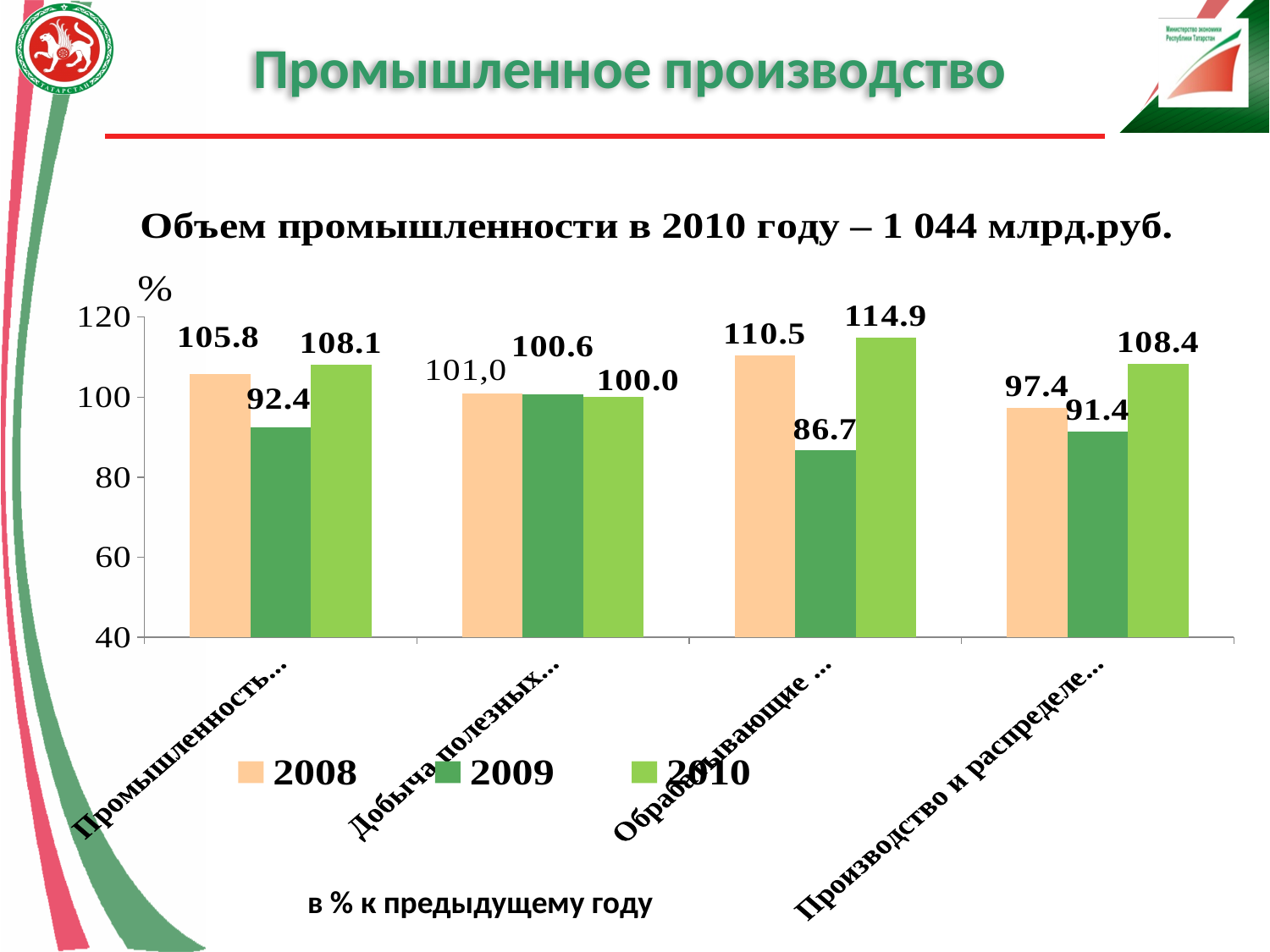
What is the difference between the 2010 and 2009 values for the category labelled "Обрабатывающие ..."? 28.2 What kind of chart is shown on the slide? bar chart Which category has the highest 2010 value? Обрабатывающие ... How many series does the legend list? 3 What is the 2010 value for the category labelled "Обрабатывающие ..."? 114.9 What is the 2008 value for the category labelled "Производство и распределе..."? 97.4 What is the 2009 value for the category labelled "Промышленность..."? 92.4 How many categories are shown on the x axis? 4 What is the 2010 value for the category labelled "Добыча полезных..."? 100.0 Which category has the lowest 2009 value? Обрабатывающие ... What unit is indicated at the top of the y axis? % Which is larger for the category labelled "Производство и распределе...": the 2008 value or the 2010 value? 2010